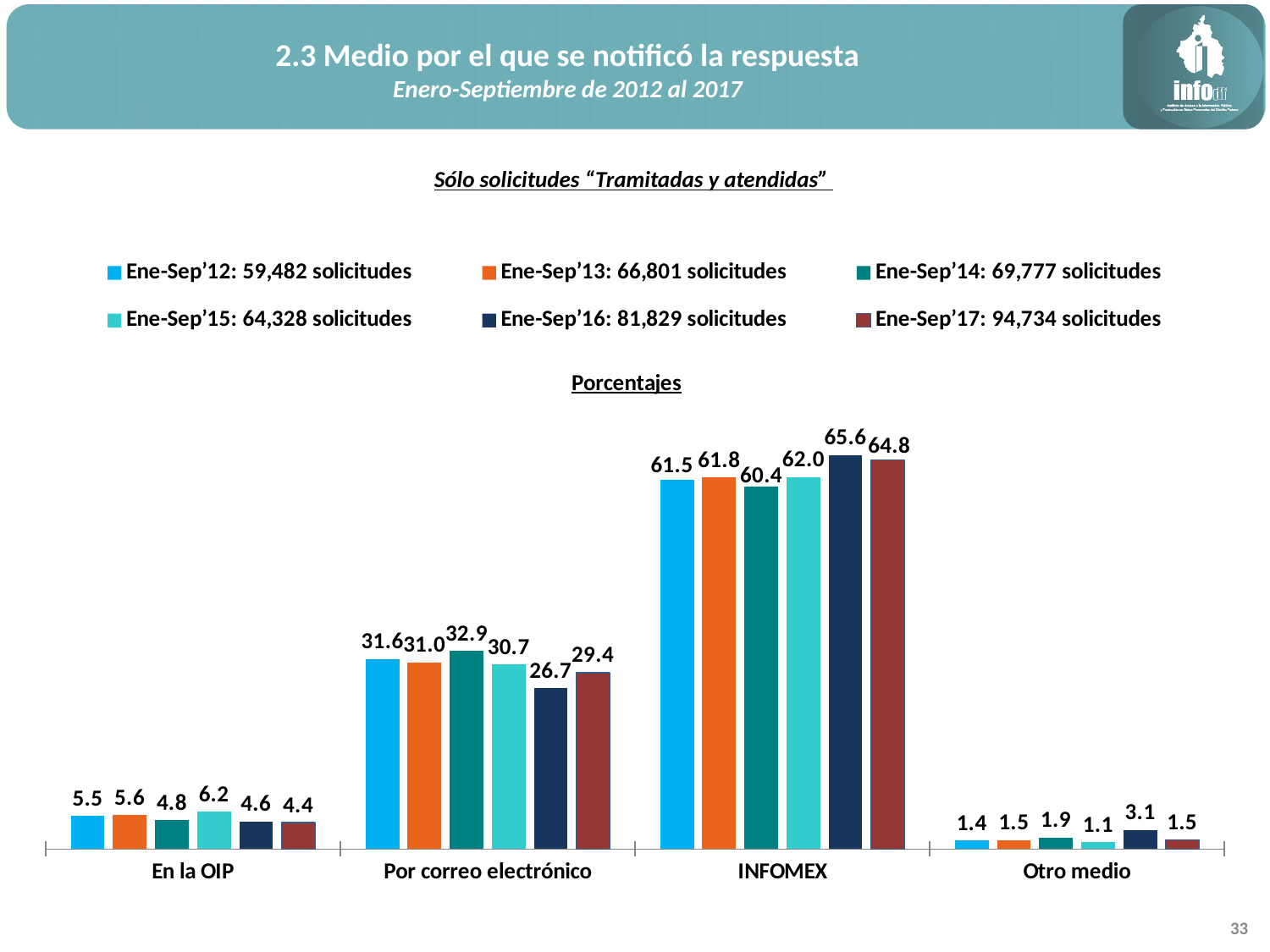
How many categories are shown on the x axis? 4 What is the difference between the Ene-Sep'16 and Ene-Sep'12 values for INFOMEX? 4.1 What kind of chart is shown on the slide? Bar chart What is the value for En la OIP in the Ene-Sep'15 series? 6.2 Which category has the highest values across all series? INFOMEX According to the legend, how many solicitudes were there in Ene-Sep'17? 94,734 Which series has the lowest value for Por correo electrónico? Ene-Sep'16 What is the value for INFOMEX in the Ene-Sep'16 series? 65.6 What is the value for Por correo electrónico in the Ene-Sep'14 series? 32.9 What is the value for Otro medio in the Ene-Sep'16 series? 3.1 How many series does the legend list? 6 Which is larger for Otro medio: the Ene-Sep'14 value or the Ene-Sep'15 value? Ene-Sep'14